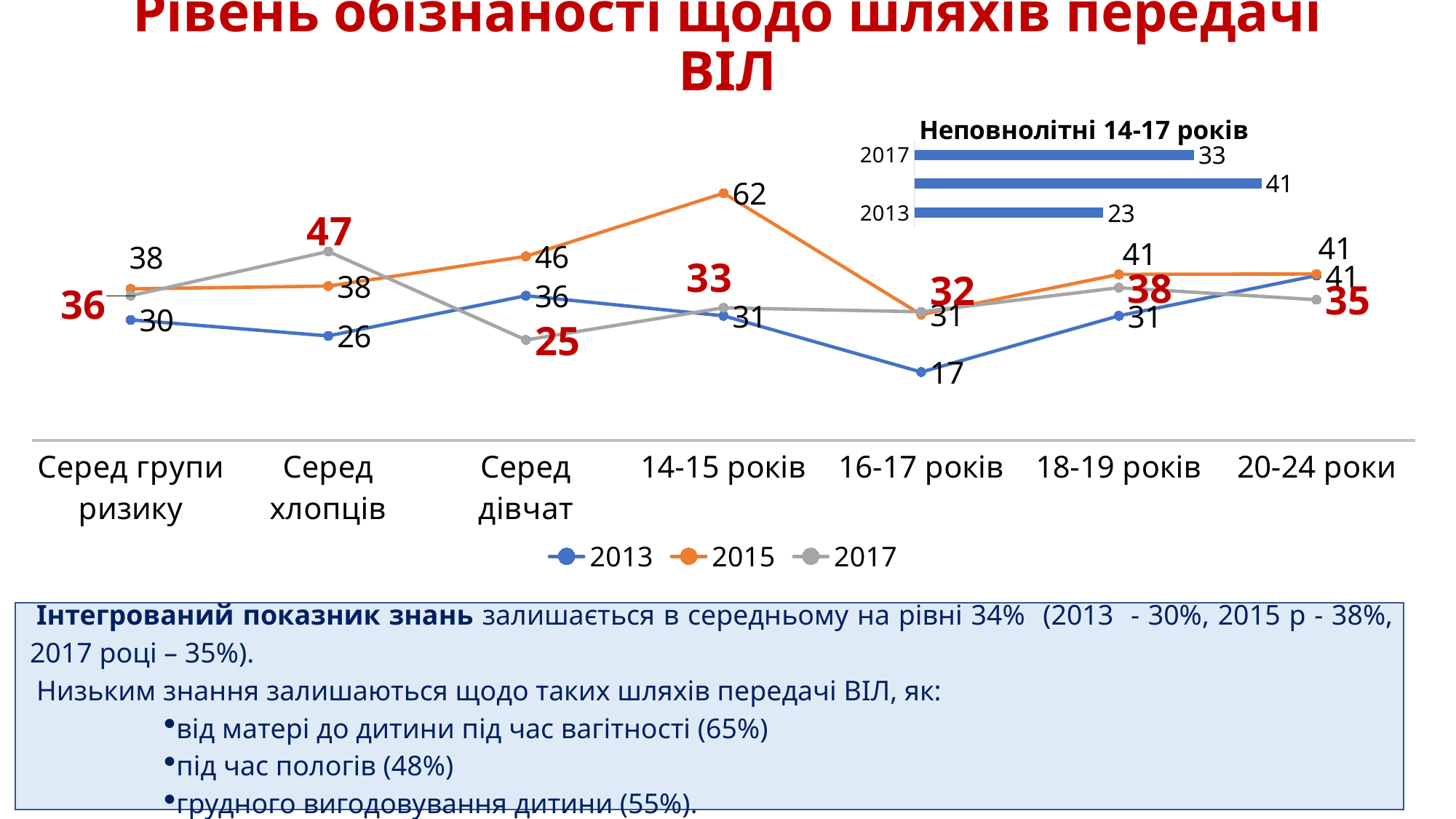
In the main line chart, what is the 2017 value for Серед хлопців? 47 In the main line chart, how many series does the legend list? 3 In the main line chart, which category has the lowest 2013 value? 16-17 років In the main line chart, what is the difference between the 2015 and 2013 values for 14-15 років? 31 What kind of chart is the main chart with the legend 2013, 2015, 2017? line chart In the bar chart titled Неповнолітні 14-17 років, what is the difference between the 2017 and 2013 values? 10 In the main line chart, what is the 2013 value for 16-17 років? 17 In the main line chart, what is the 2015 value for 14-15 років? 62 In the main line chart, how many categories are shown on the x axis? 7 In the bar chart titled Неповнолітні 14-17 років, what is the value for 2013? 23 In the main line chart, which category has the highest 2015 value? 14-15 років In the main line chart, for Серед дівчат, which is larger: the 2015 value or the 2017 value? 2015